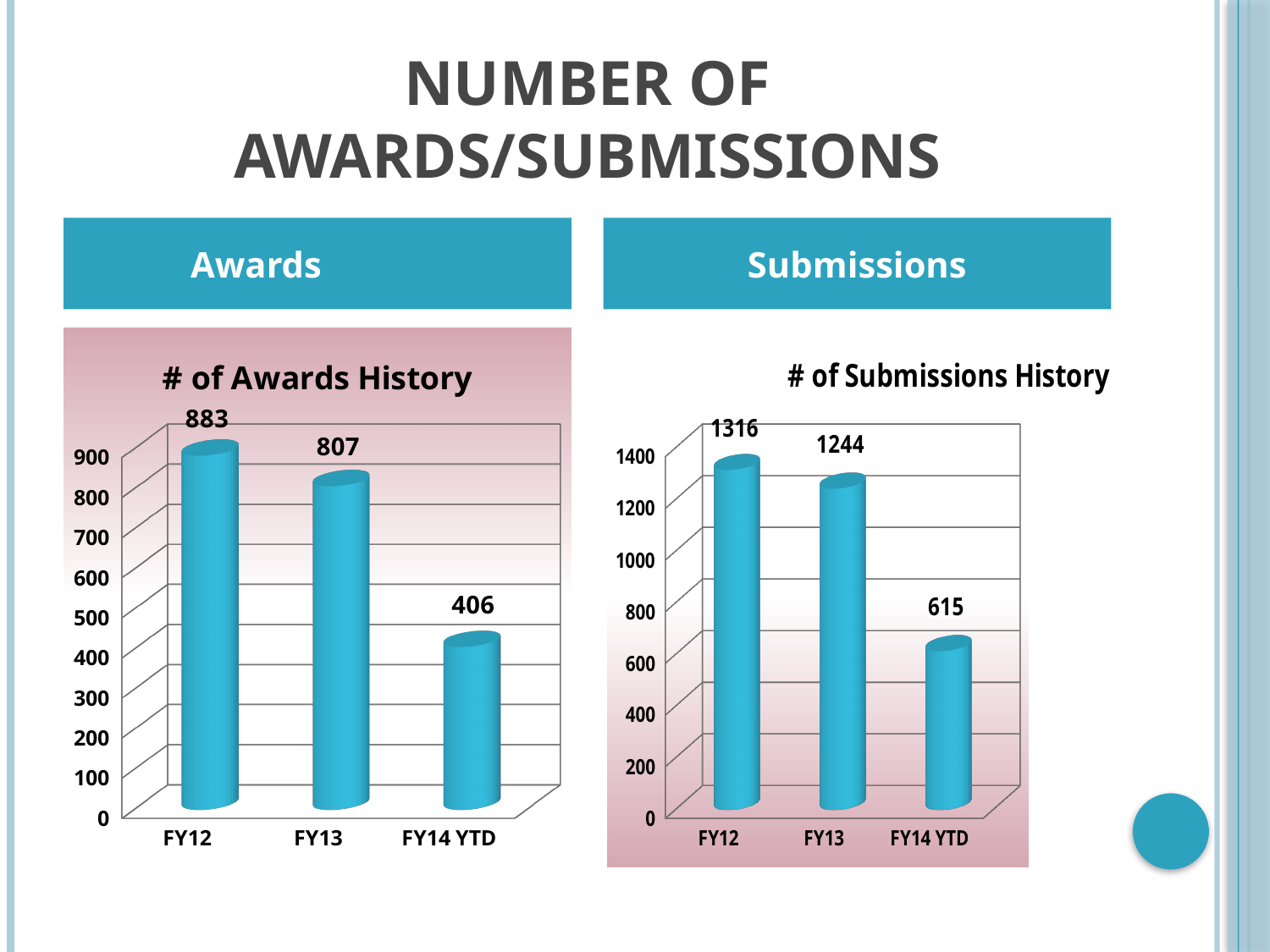
In the '# of Awards History' chart, do the values rise or fall from FY12 to FY14 YTD? Fall What kind of chart is the '# of Submissions History' chart? Bar chart In the '# of Submissions History' chart, which category has the lowest value? FY14 YTD In the '# of Awards History' chart, what is the difference between the FY12 and FY13 values? 76 In the '# of Awards History' chart, what is the value for FY14 YTD? 406 In the '# of Submissions History' chart, which is larger, the value for FY12 or FY13? FY12 In the '# of Awards History' chart, what is the value for FY12? 883 In the '# of Submissions History' chart, what is the value for FY14 YTD? 615 In the '# of Submissions History' chart, what is the difference between the FY12 and FY14 YTD values? 701 In the '# of Awards History' chart, which category has the highest value? FY12 How many categories are shown in the '# of Awards History' chart? 3 In the '# of Submissions History' chart, what is the value for FY13? 1244